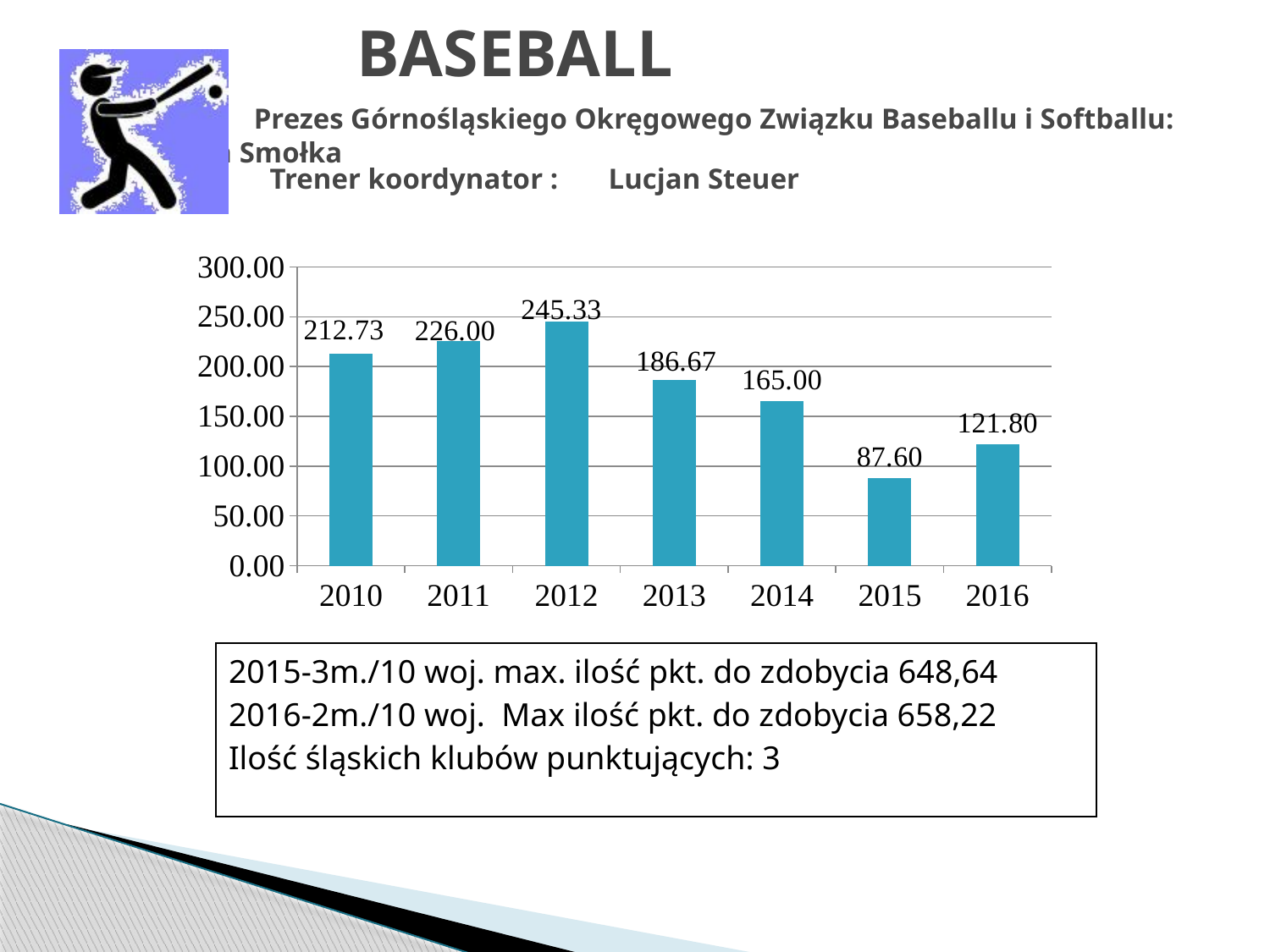
What is the value for 2012? 245.33 Which year has the lowest value? 2015 Do the values rise or fall from 2012 to 2015? fall How many years are shown on the x axis? 7 What is the difference between the values for 2016 and 2015? 34.20 What kind of chart is shown on the slide? bar chart What is the value for 2010? 212.73 Which is larger, the value for 2013 or the value for 2014? 2013 Is the value for 2014 greater or less than 150.00? greater What is the value for 2015? 87.60 Which year has the highest value? 2012 What is the difference between the values for 2011 and 2010? 13.27